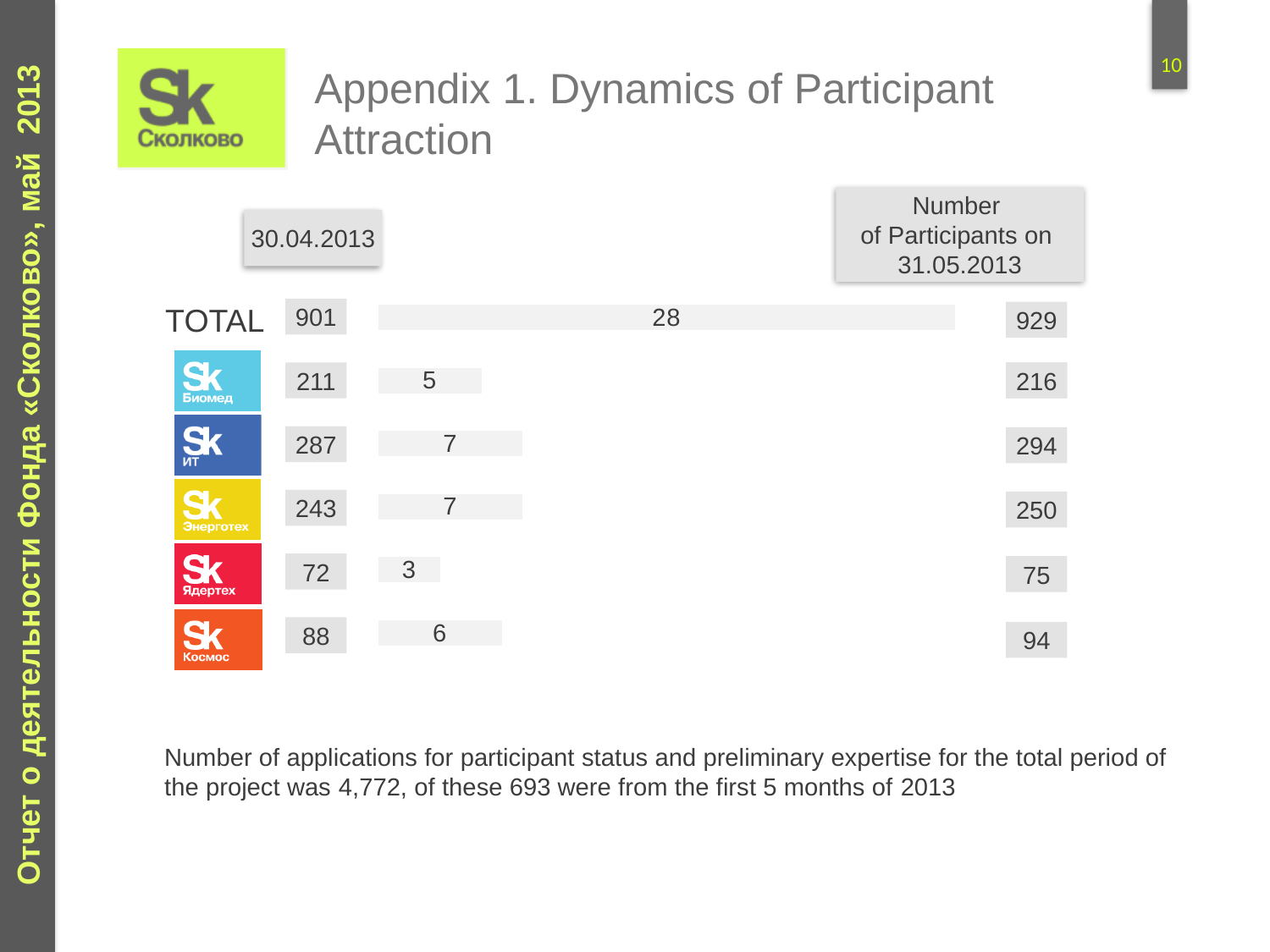
Excluding the TOTAL row, which cluster had the largest increase in participants between 30.04.2013 and 31.05.2013? ИТ and Энерготех (7 each) Which cluster had more participants on 31.05.2013, Биомед or Энерготех? Энерготех How many participants were added in the ИТ cluster between 30.04.2013 and 31.05.2013, according to the bar? 7 How many participants did the Ядертех cluster have on 30.04.2013? 72 What was the total number of participants on 30.04.2013? 901 How many participants did the Космос cluster have on 31.05.2013? 94 What is the difference between the total number of participants on 31.05.2013 and on 30.04.2013? 28 Excluding the TOTAL row, which cluster had the smallest increase in participants between 30.04.2013 and 31.05.2013? Ядертех What kind of chart is used to show the increase in participants? Bar chart What was the total number of participants on 31.05.2013? 929 What is the title of the slide containing the chart? Appendix 1. Dynamics of Participant Attraction How many clusters (excluding TOTAL) are shown in the chart? 5